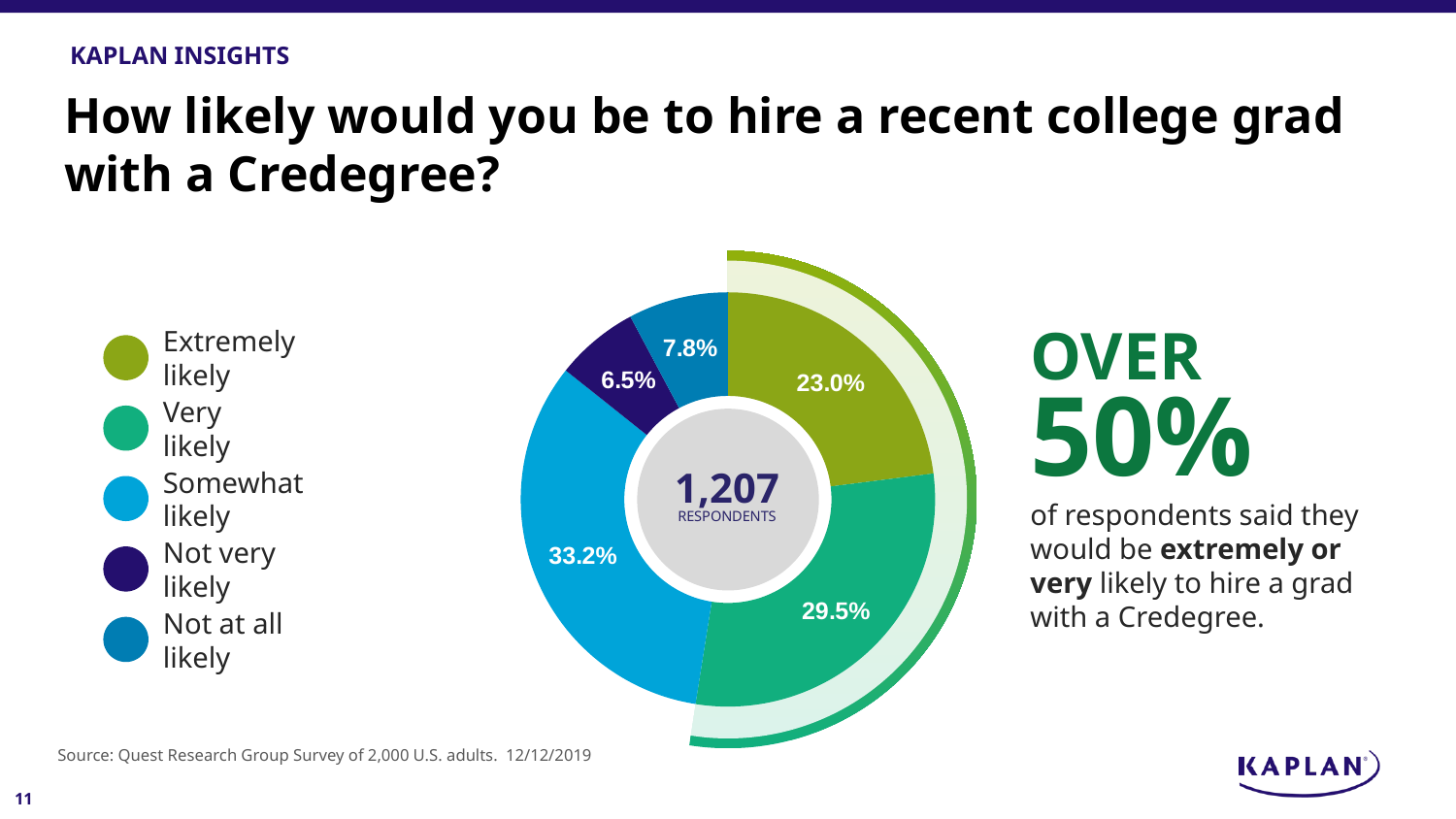
How many respondents are shown in the center of the chart? 1,207 Which is larger: the share for 'Somewhat likely' or the share for 'Very likely'? Somewhat likely What is the combined share of respondents who said 'Extremely likely' or 'Very likely'? 52.5% Which response category has the smallest share of respondents? Not very likely What percentage of respondents said they would be not at all likely to hire a recent college grad with a Credegree? 7.8% How many response categories are shown in the chart? 5 What is the difference in percentage points between the 'Very likely' and 'Extremely likely' shares? 6.5 What kind of chart is used to show the responses? Pie chart (donut) What percentage of respondents said they would be extremely likely to hire a recent college grad with a Credegree? 23.0% What percentage of respondents said they would be somewhat likely to hire a recent college grad with a Credegree? 33.2% What percentage of respondents said they would be not very likely to hire a recent college grad with a Credegree? 6.5% Which response category has the largest share of respondents? Somewhat likely